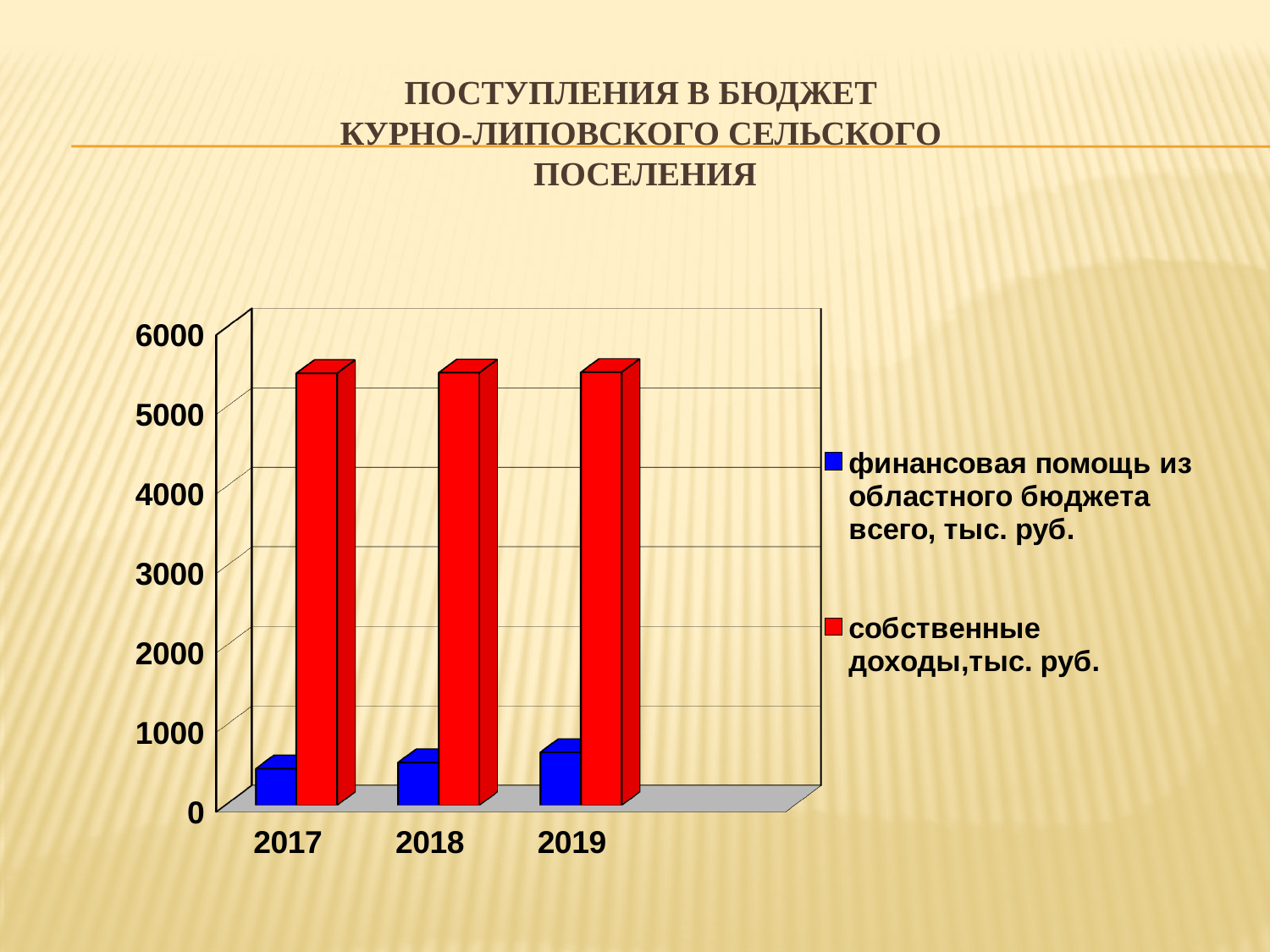
Is the value for финансовая помощь из областного бюджета in 2019 greater or less than 1000? less Which colour represents собственные доходы in the chart's legend? red In which year is финансовая помощь из областного бюджета the highest? 2019 In 2018, which is larger: собственные доходы or финансовая помощь из областного бюджета? собственные доходы Is the value for собственные доходы in 2017 greater or less than 5000? greater Is the value for финансовая помощь из областного бюджета in 2017 greater or less than 1000? less What kind of chart is shown on the slide? bar chart In which year is финансовая помощь из областного бюджета the lowest? 2017 How many years are shown on the x axis of the chart? 3 How many series does the chart's legend list? 2 Do the values for финансовая помощь из областного бюджета rise or fall from 2017 to 2019? rise